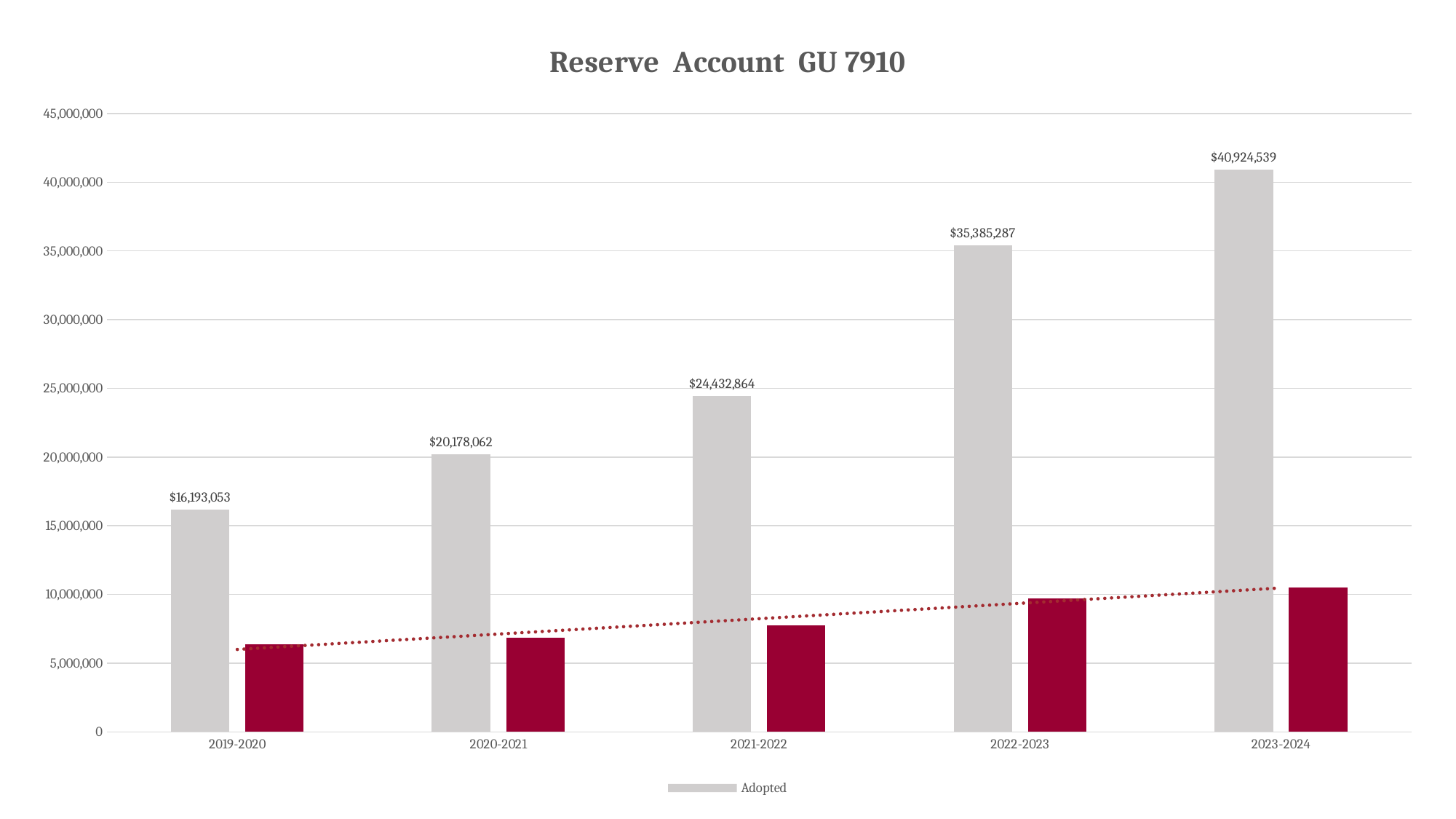
What kind of chart is shown on the slide? bar chart Which is larger, the Adopted value for 2020-2021 or for 2021-2022? 2021-2022 What is the Adopted value for 2023-2024? $40,924,539 What is the Adopted value for 2019-2020? $16,193,053 What is the difference between the Adopted values for 2023-2024 and 2019-2020? $24,731,486 Which year has the lowest Adopted value? 2019-2020 What is the Adopted value for 2021-2022? $24,432,864 Which year has the highest Adopted value? 2023-2024 What is the difference between the Adopted values for 2022-2023 and 2021-2022? $10,952,423 Is the value of the dark red bar for 2019-2020 greater or less than 10,000,000? less How many years are shown on the x axis? 5 Do the Adopted values rise or fall from 2019-2020 to 2023-2024? rise